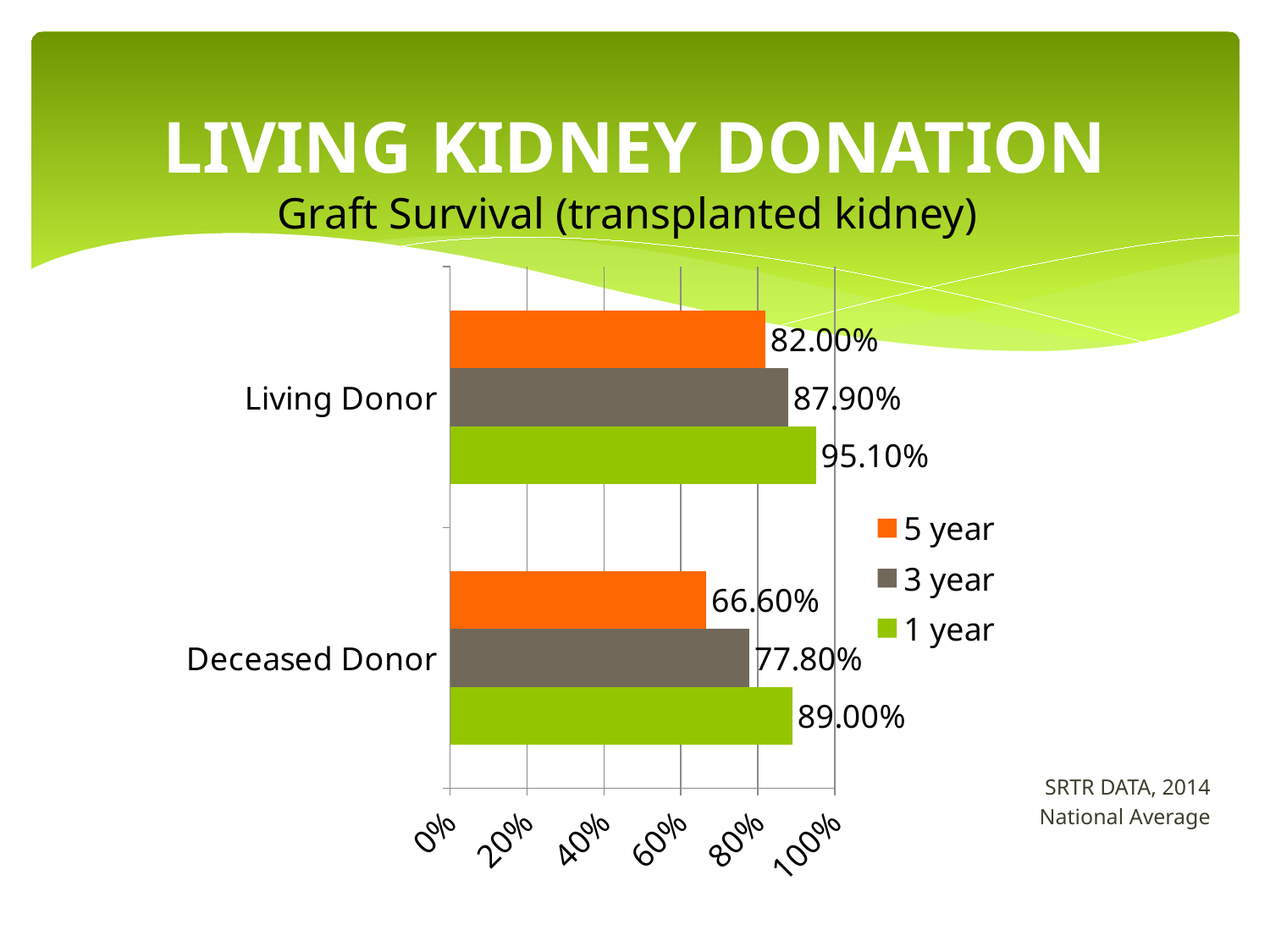
What kind of chart is shown on the slide? Bar chart Which colour represents the 1 year series in the legend? Green How many series does the legend list? 3 What is the difference between the 5 year values for Living Donor and Deceased Donor? 15.40% What is the 5 year graft survival value for Deceased Donor? 66.60% Which bar shows the lowest value on the chart? Deceased Donor, 5 year What is the 1 year graft survival value for Deceased Donor? 89.00% Which is larger: the 3 year value for Deceased Donor or the 5 year value for Living Donor? 5 year value for Living Donor What is the 1 year graft survival value for Living Donor? 95.10% How many donor categories are shown on the chart? 2 Which bar shows the highest value on the chart? Living Donor, 1 year What is the 3 year graft survival value for Living Donor? 87.90%